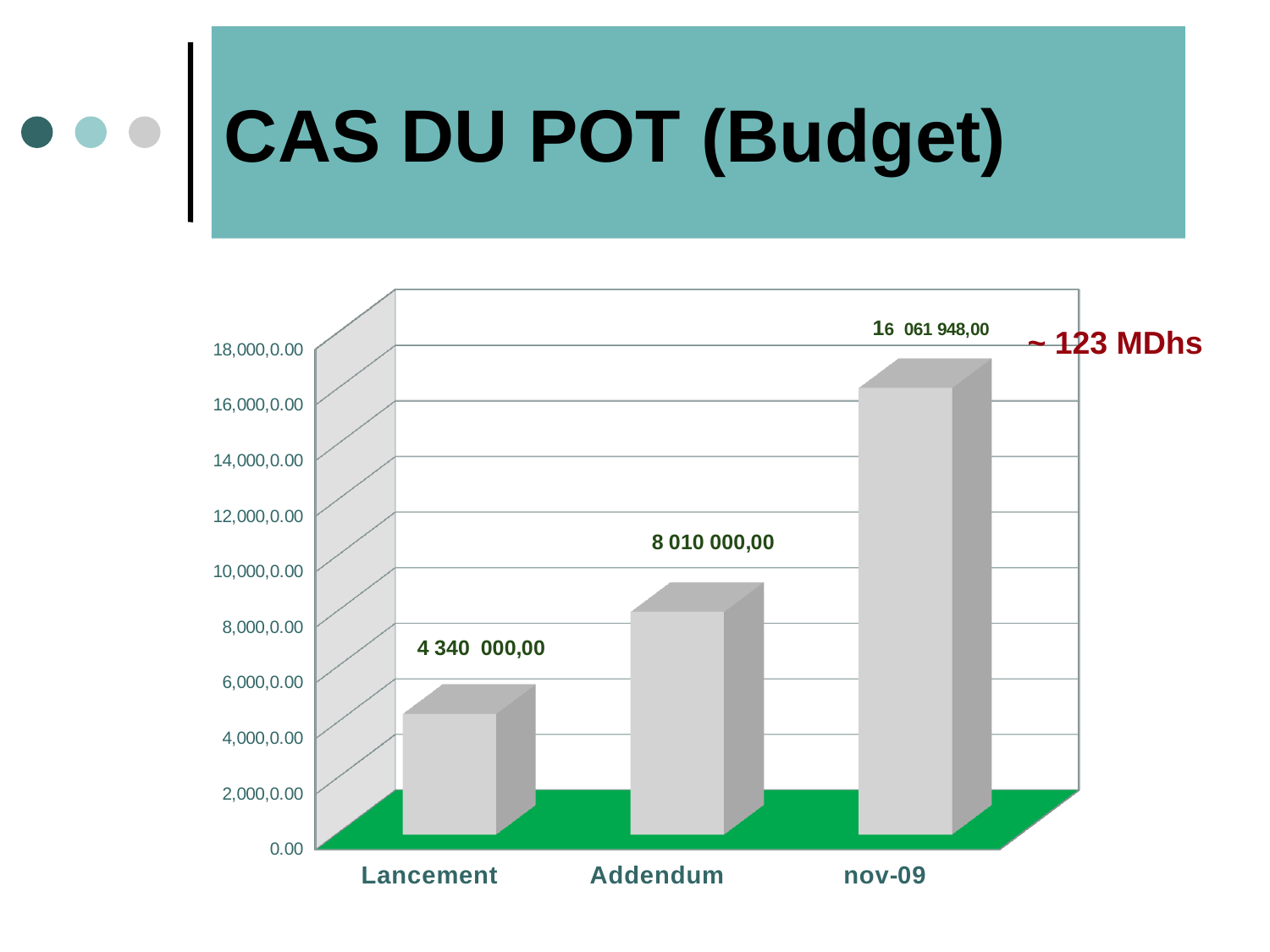
What is the value for Addendum? 8 010 000,00 What is the value for Lancement? 4 340 000,00 What kind of chart is shown on the slide? bar chart Which category has the highest value? nov-09 How many categories are shown on the x axis? 3 Which is larger, the value for Addendum or the value for Lancement? Addendum What annotation is written in red next to the nov-09 bar? ~ 123 MDhs Which category has the lowest value? Lancement What is the difference between the values for nov-09 and Addendum? 8 051 948,00 Do the values rise or fall from Lancement to nov-09? rise What is the difference between the values for Addendum and Lancement? 3 670 000,00 What is the value for nov-09? 16 061 948,00